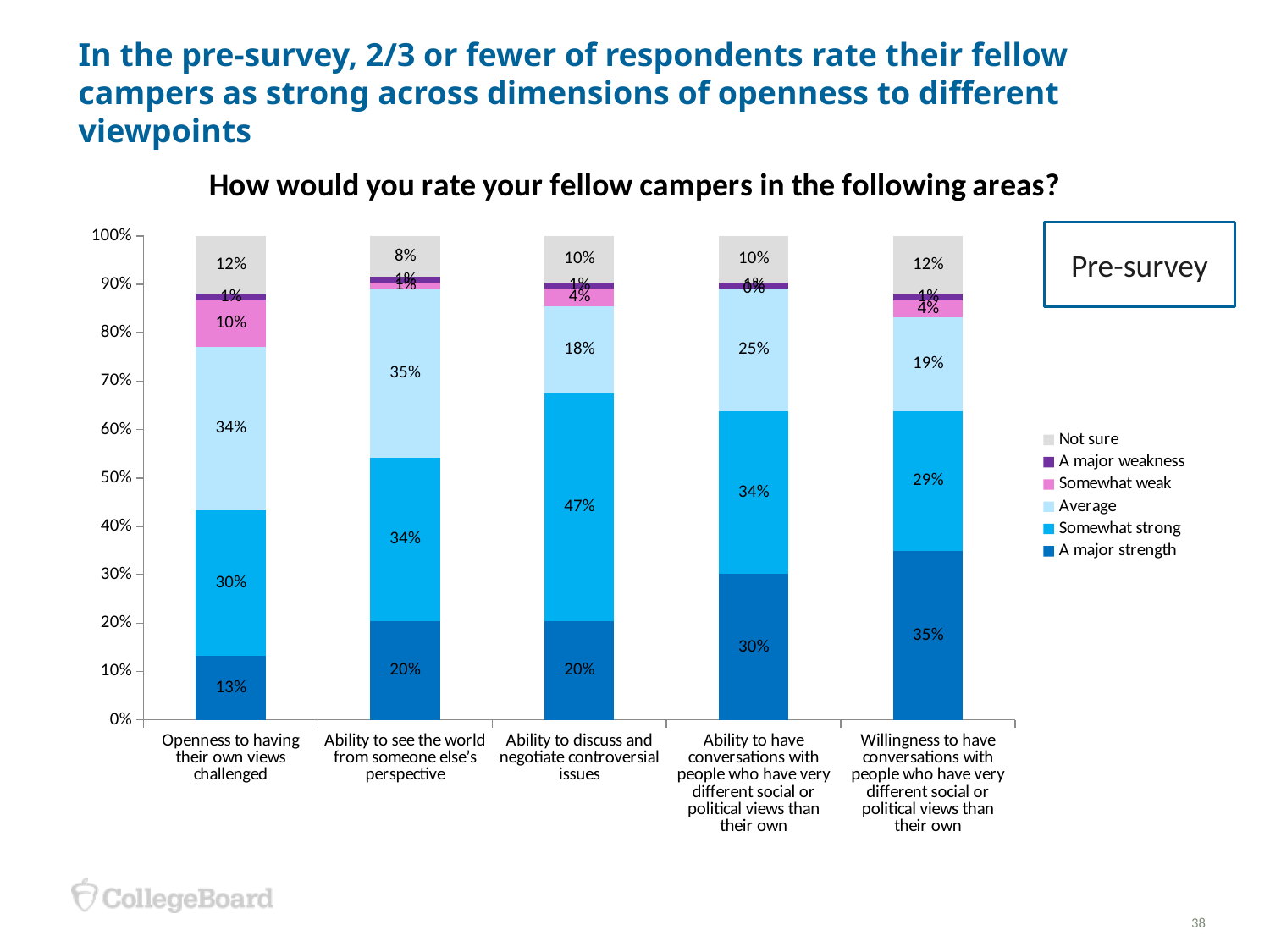
What does the box to the right of the chart say? Pre-survey What percentage of respondents rated 'Willingness to have conversations with people who have very different social or political views than their own' as a major strength? 35% Which is larger: the 'Somewhat strong' percentage for 'Ability to have conversations with people who have very different social or political views than their own' or for 'Willingness to have conversations with people who have very different social or political views than their own'? Ability to have conversations with people who have very different social or political views than their own What is the 'Not sure' percentage for 'Ability to see the world from someone else's perspective'? 8% What type of chart is shown on the slide? Stacked bar chart Which area has the lowest 'A major strength' percentage? Openness to having their own views challenged What percentage rated 'Openness to having their own views challenged' as somewhat weak? 10% How many areas (categories) are shown on the x axis of the chart? 5 Which area has the highest 'A major strength' percentage? Willingness to have conversations with people who have very different social or political views than their own How many series does the legend list? 6 What is the difference between the 'Average' percentage for 'Ability to see the world from someone else's perspective' and for 'Ability to discuss and negotiate controversial issues'? 17% What percentage of respondents rated 'Ability to discuss and negotiate controversial issues' as somewhat strong? 47%